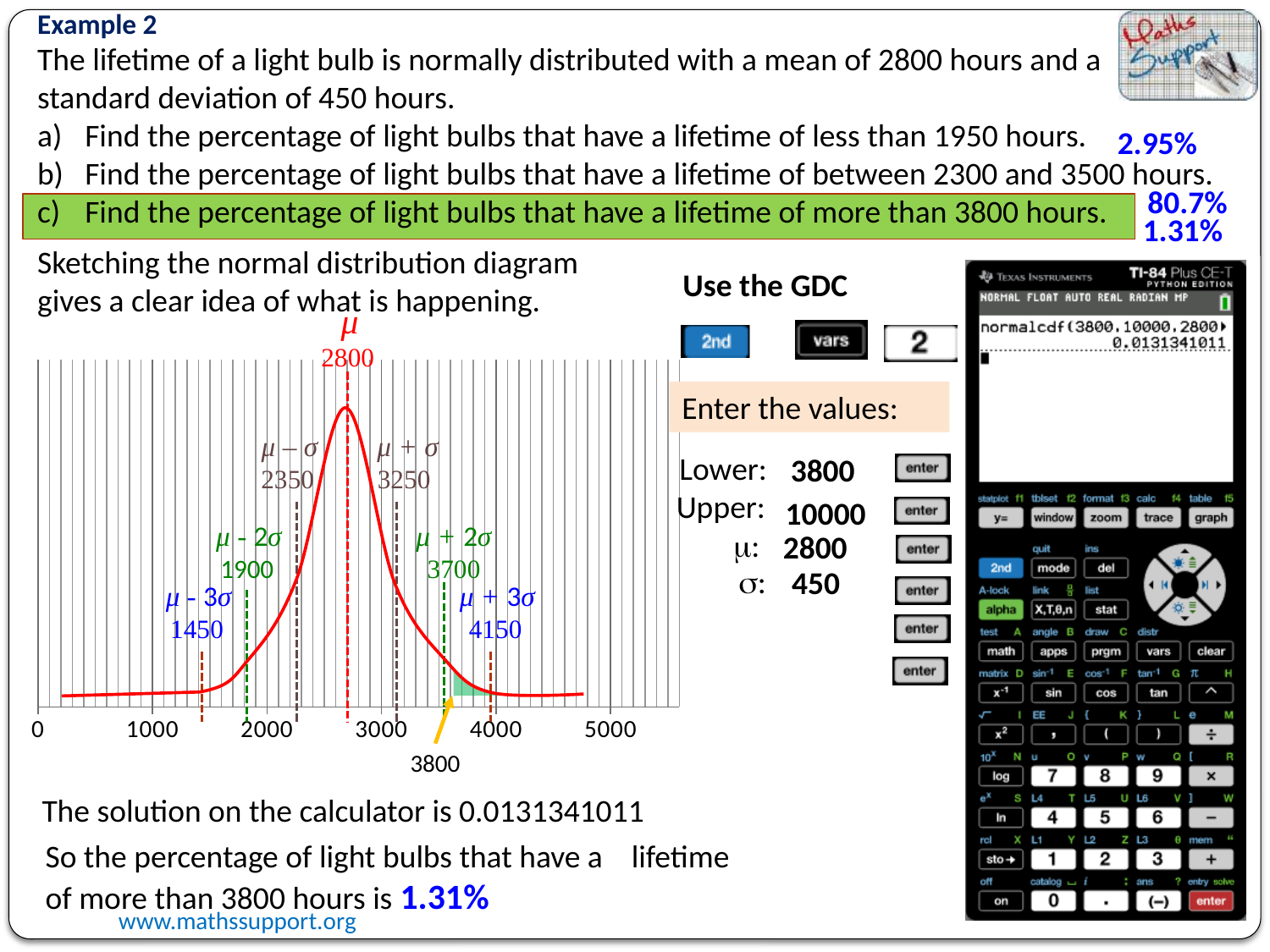
What is the difference between the values labelled at μ + 3σ and μ on the diagram? 1350 What value is labelled at the mean (μ) on the normal distribution diagram? 2800 What is the difference between the values labelled at μ + σ and μ − σ on the diagram? 900 What kind of chart is the normal distribution diagram on the slide? line chart What value is labelled at μ − σ on the normal distribution diagram? 2350 What is the largest value printed on the horizontal axis of the normal distribution diagram? 5000 What value is labelled at μ + 2σ on the normal distribution diagram? 3700 What value does the orange arrow below the diagram point to? 3800 What value is labelled at μ − 3σ on the normal distribution diagram? 1450 Which is larger on the diagram, the value labelled at μ + 2σ or the value marked by the arrow (3800)? 3800 What value is labelled at μ + σ on the normal distribution diagram? 3250 What value is labelled at μ + 3σ on the normal distribution diagram? 4150